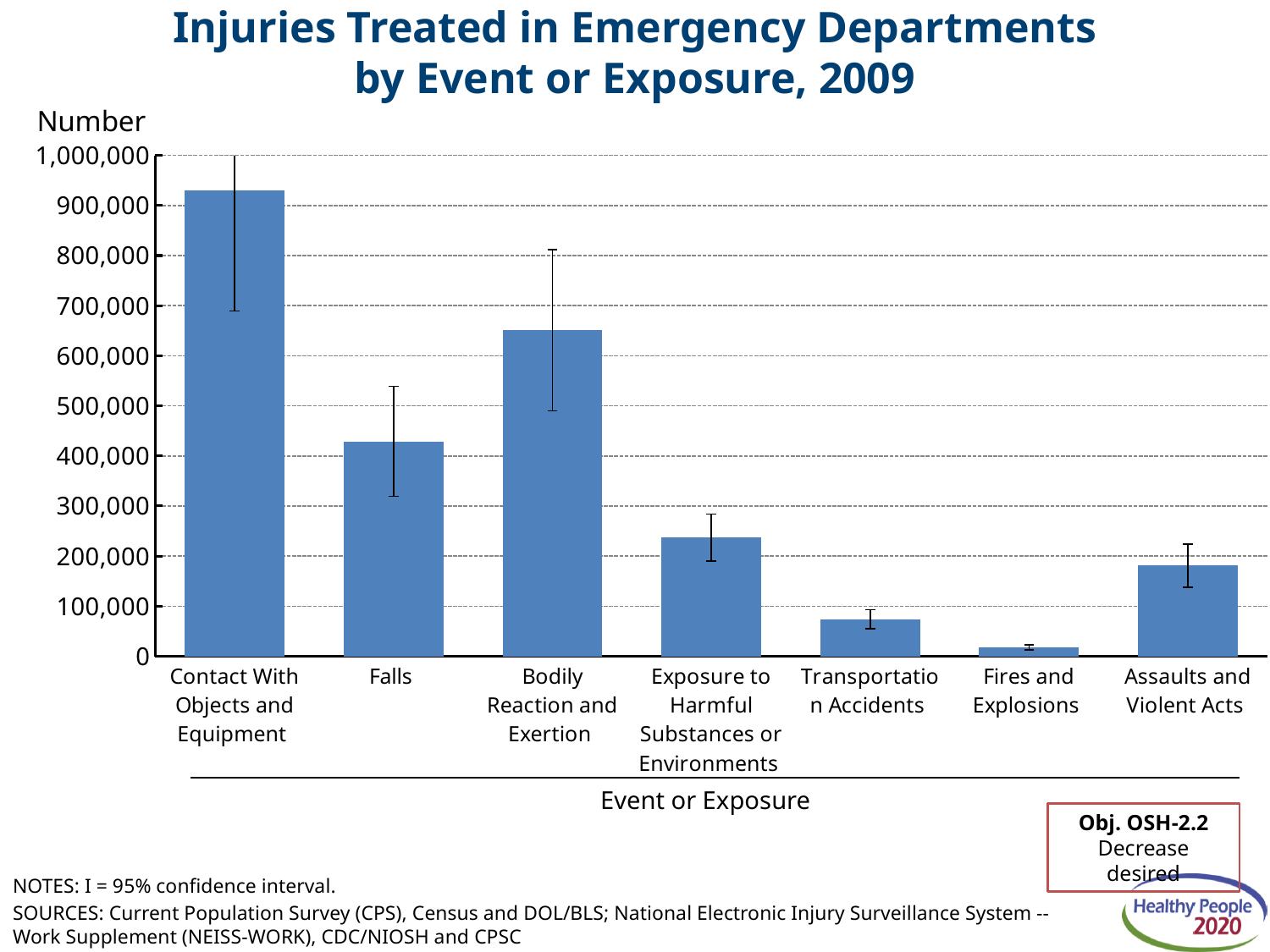
Is the value for Contact With Objects and Equipment greater or less than 800,000? greater What is the label of the x axis of the chart? Event or Exposure Is the value for Falls greater or less than 400,000? greater Is the value for Assaults and Violent Acts greater or less than 100,000? greater Which event or exposure category has the lowest number of injuries treated in emergency departments? Fires and Explosions How many event or exposure categories are shown on the chart? 7 Which has more injuries treated in emergency departments, Exposure to Harmful Substances or Environments or Transportation Accidents? Exposure to Harmful Substances or Environments Which has more injuries treated in emergency departments, Falls or Bodily Reaction and Exertion? Bodily Reaction and Exertion Which event or exposure category has the highest number of injuries treated in emergency departments? Contact With Objects and Equipment What type of chart is shown on the slide? bar chart